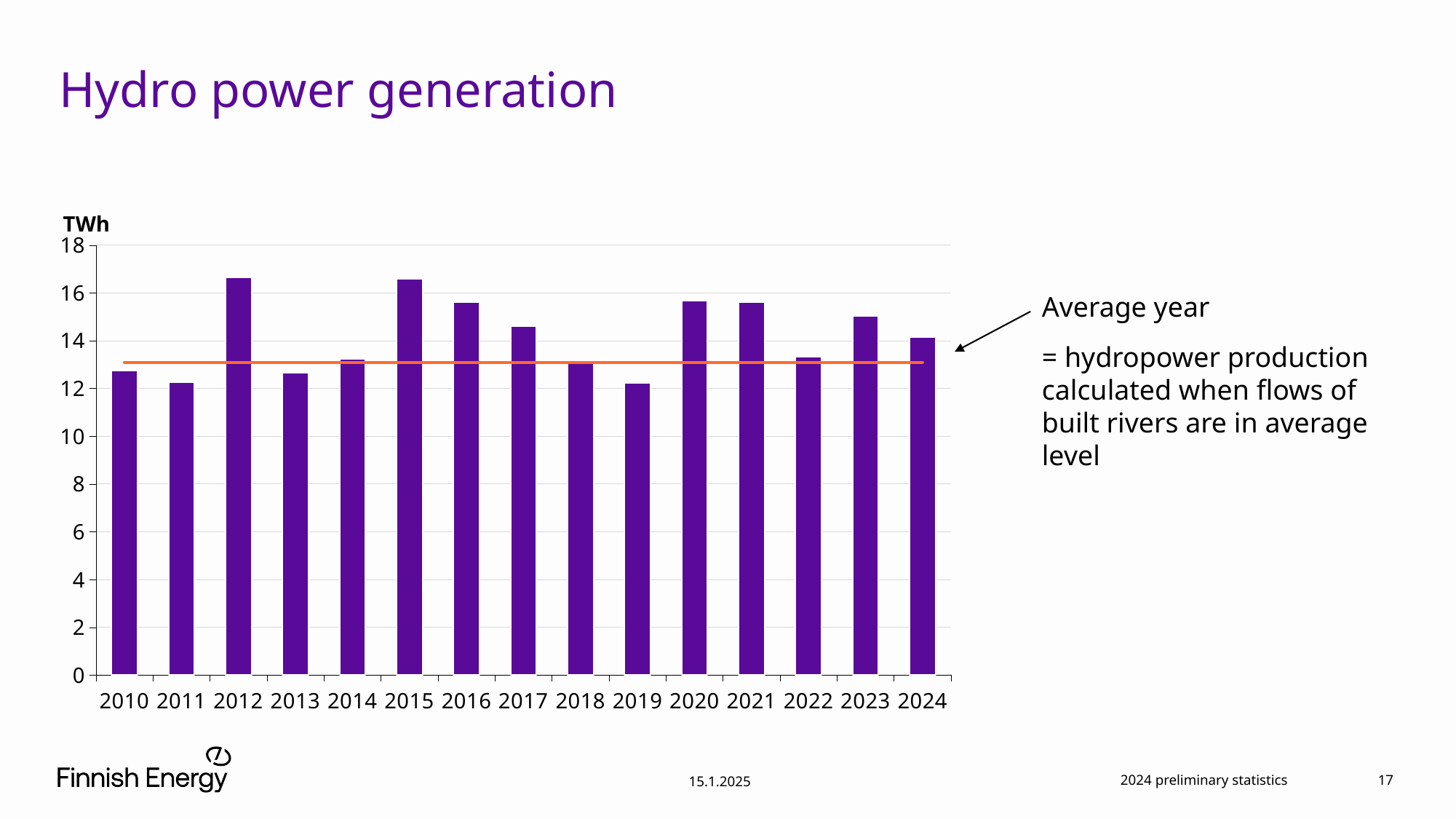
What kind of chart is shown on the slide? bar chart Is the value for 2011 greater or less than 14? less Is the value for 2023 greater or less than 14? greater How many years are shown on the x axis of the chart? 15 Do the values rise or fall from 2015 to 2019? fall Which year has the higher value, 2012 or 2013? 2012 Which year has the higher value, 2016 or 2017? 2016 Is the value for 2012 greater or less than 16? greater What does the orange horizontal line on the chart represent? Average year What unit is shown on the y axis of the chart? TWh